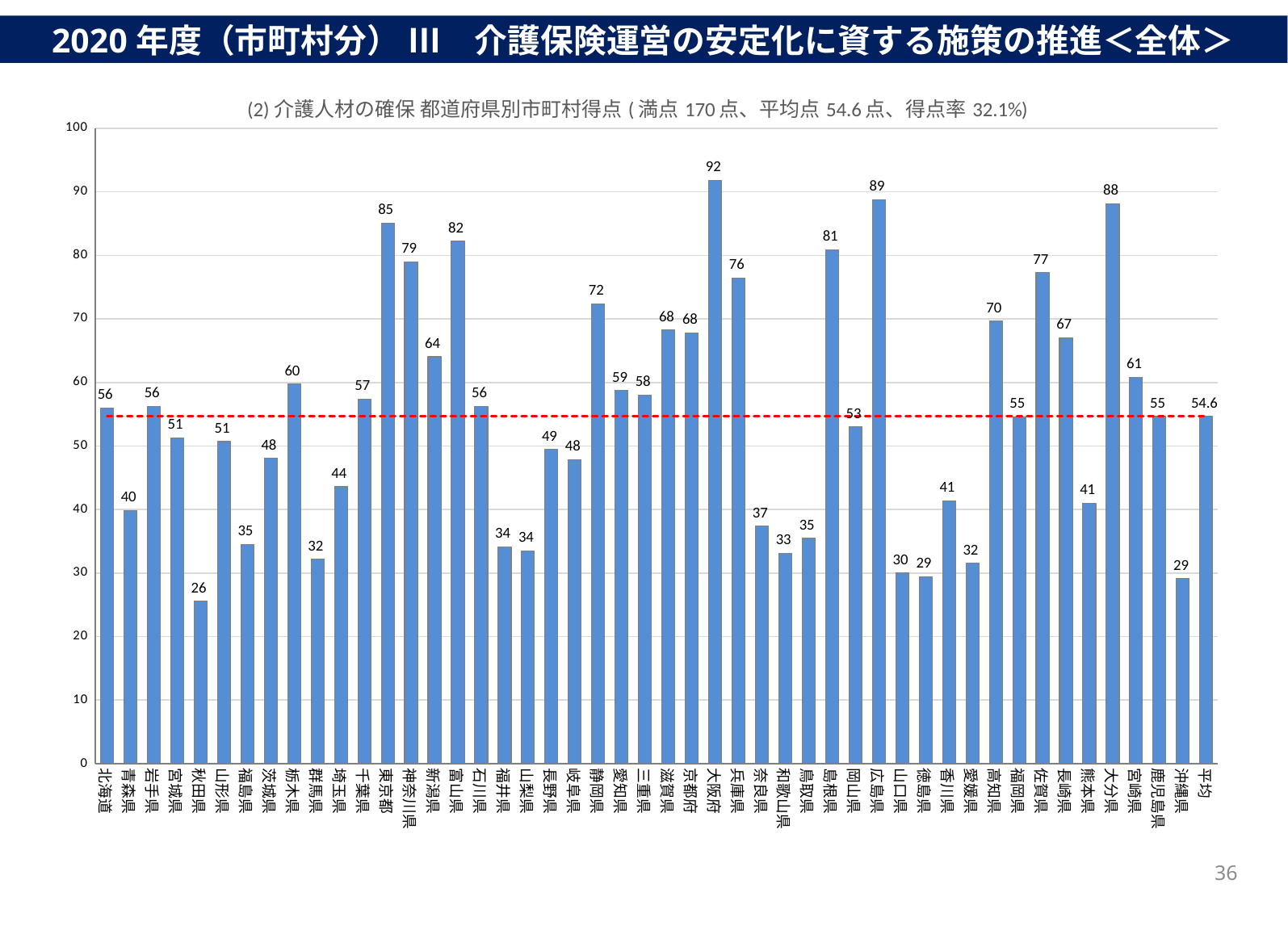
What is the value for 東京都? 85 What type of chart is shown on the slide? bar chart What is the 平均点 (average score) stated in the chart title? 54.6点 How many bars are plotted in the chart, including the 平均 bar? 48 Which is larger, the value for 東京都 or the value for 神奈川県? 東京都 What is the difference between the values for 大阪府 and 秋田県? 66 Which category has the highest value? 大阪府 What is the value for 大阪府? 92 Is the value for 広島県 greater or less than 80? greater What is the value for 秋田県? 26 What is the value shown for 平均 (the average bar)? 54.6 Which category has the lowest value? 秋田県